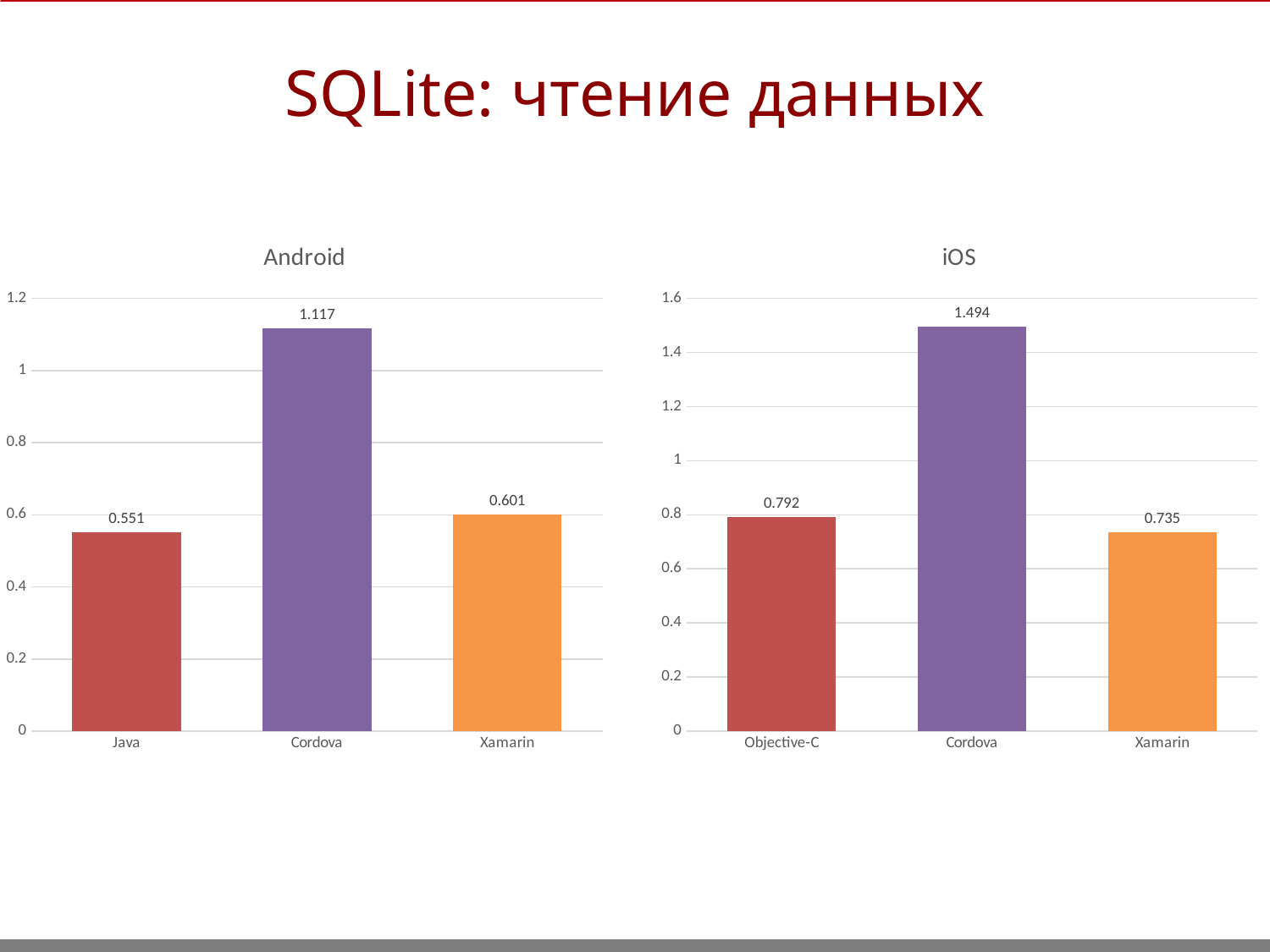
In the Android chart, what is the value for Cordova? 1.117 In the Android chart, what is the difference between the Xamarin value and the Java value? 0.050 In the Android chart, which category has the lowest value? Java In the iOS chart, what is the value for Xamarin? 0.735 In the Android chart, what is the value for Java? 0.551 In the iOS chart, which category has the lowest value? Xamarin In the iOS chart, what is the difference between the Cordova value and the Objective-C value? 0.702 How many categories does the iOS chart show? 3 In the Android chart, which category has the highest value? Cordova In the iOS chart, what is the value for Objective-C? 0.792 What kind of chart is the Android chart? Bar chart In the iOS chart, which is larger, the value for Objective-C or the value for Xamarin? Objective-C